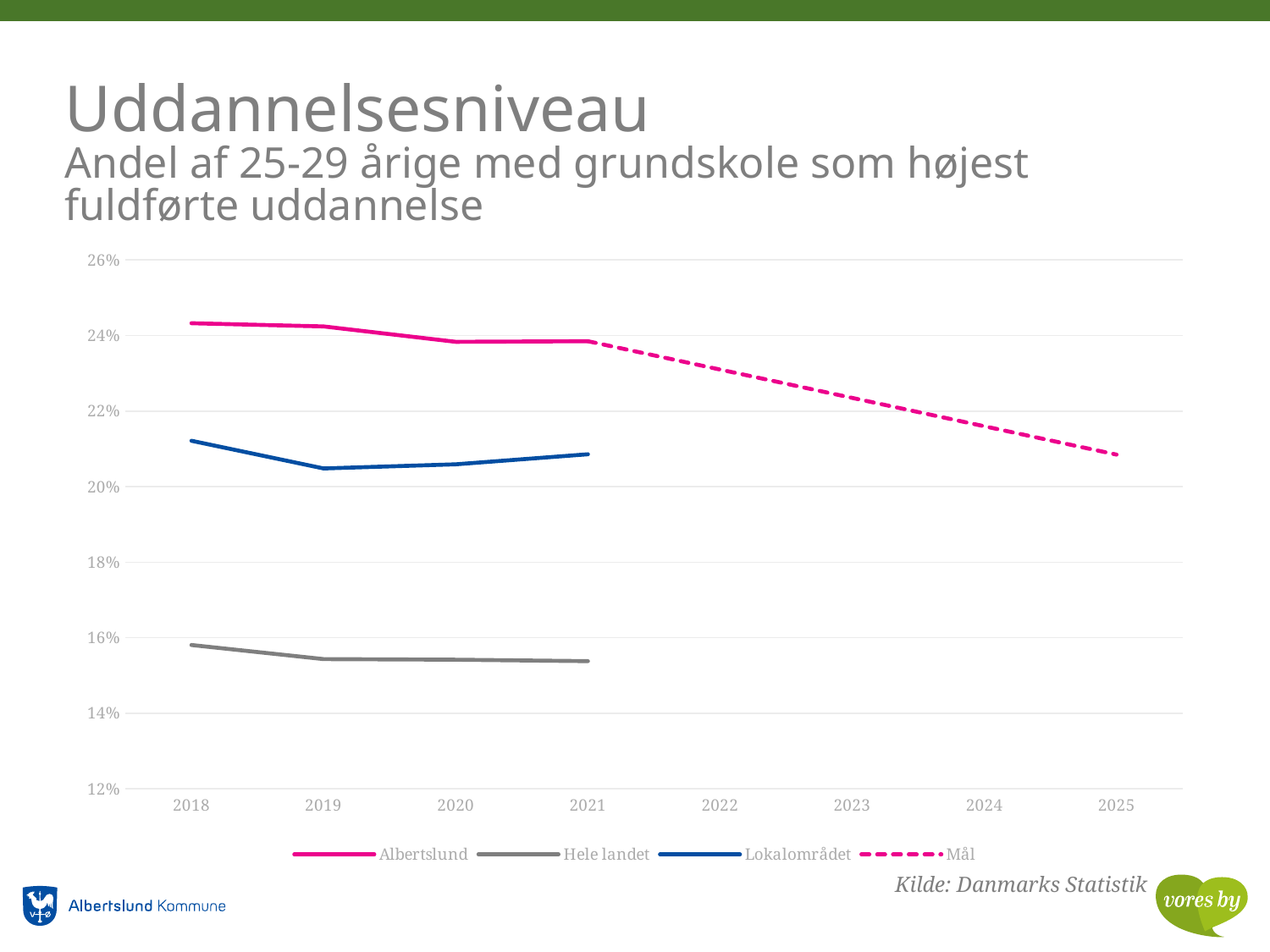
In 2021, which is larger: Albertslund or Hele landet? Albertslund How many years are shown on the x axis? 8 Is the value for Hele landet in 2018 greater or less than 18%? less Which series is drawn with a dashed line? Mål Which series has the lowest value in 2020? Hele landet How many series does the legend list? 4 Which series has the highest value in 2018? Albertslund What kind of chart is shown on the slide? line chart Is the value for Lokalområdet in 2019 greater or less than 22%? less Is the value for Mål in 2025 greater or less than 22%? less Does the Mål series rise or fall from 2021 to 2025? fall